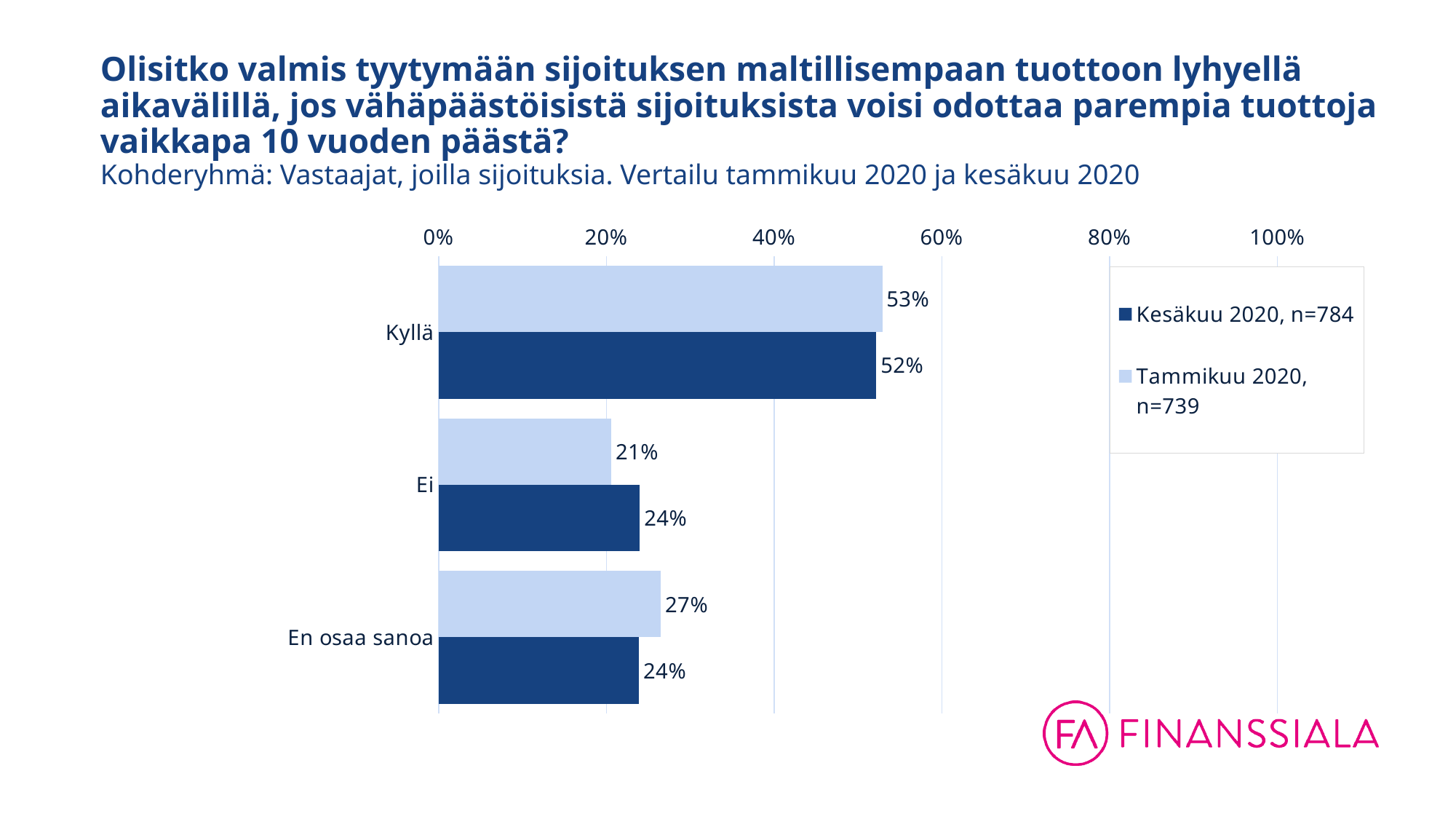
Which category has the lowest value in the Tammikuu 2020 series? Ei Which category has the highest value in the Kesäkuu 2020 series? Kyllä What is the value for Kyllä in the Kesäkuu 2020 series? 52% What is the value for Kyllä in the Tammikuu 2020 series? 53% What is the difference between the Tammikuu 2020 and Kesäkuu 2020 values for En osaa sanoa? 3% What is the value for En osaa sanoa in the Kesäkuu 2020 series? 24% What is the value for Ei in the Tammikuu 2020 series? 21% What is the sample size (n) for the Kesäkuu 2020 series according to the legend? 784 How many series does the legend list? 2 How many categories are shown on the chart? 3 What kind of chart is shown on the slide? Bar chart Which is larger for Ei: the Kesäkuu 2020 value or the Tammikuu 2020 value? Kesäkuu 2020